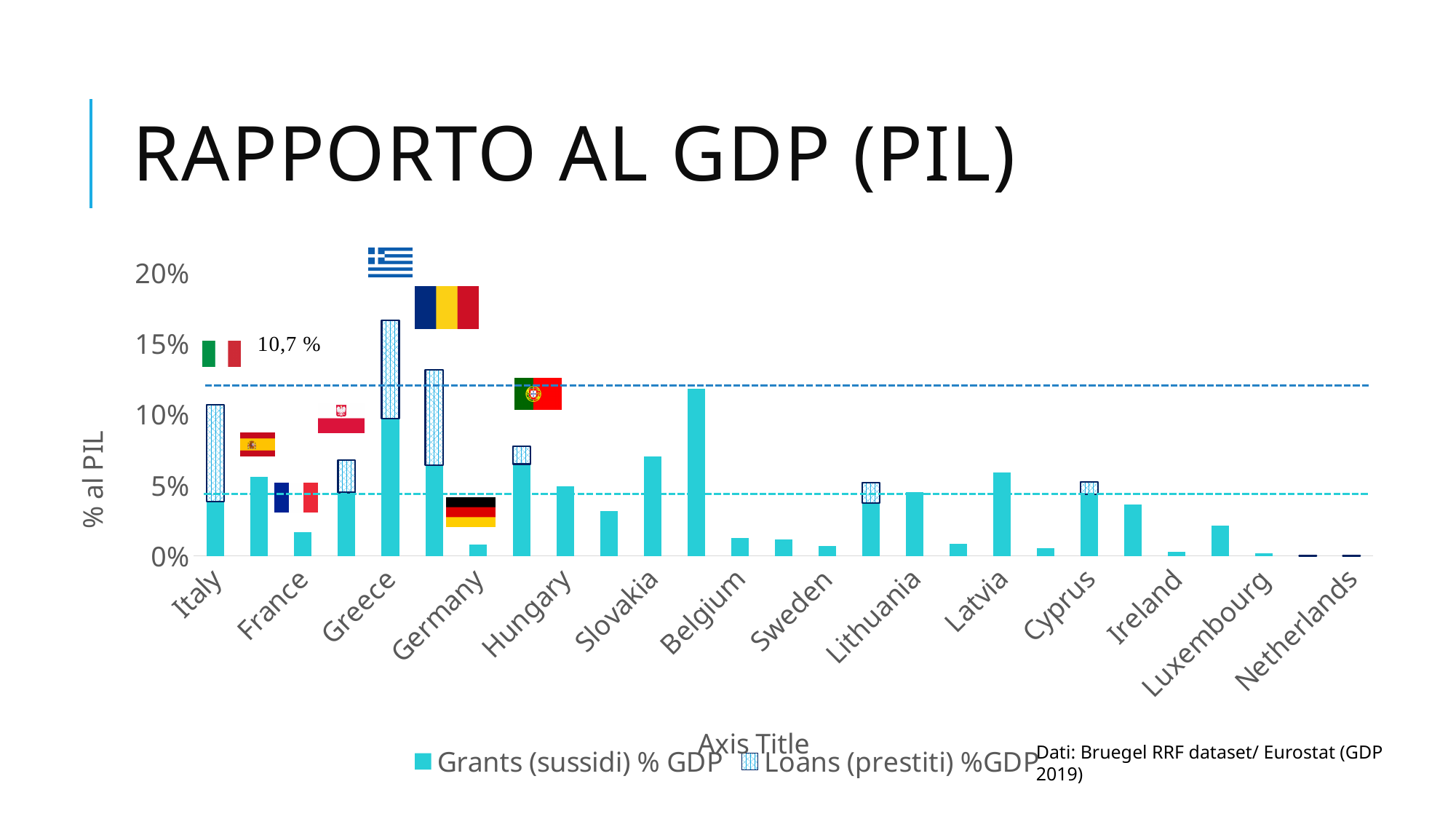
Is the grants value for France greater or less than 5%? less What total value is annotated next to the Italy bar? 10,7 % Is the grants value for Germany greater or less than 5%? less Is the grants value for Slovakia greater or less than 5%? greater What is the title of the slide's chart? RAPPORTO AL GDP (PIL) What are the two series named in the legend? Grants (sussidi) % GDP and Loans (prestiti) %GDP How many series does the chart legend list? 2 What kind of chart is shown on the slide? bar chart Which country has the tallest stacked bar (grants plus loans) in the chart? Greece Which has the larger grants value, Hungary or Belgium? Hungary Do the bar heights generally rise or fall moving from left to right along the x axis? fall